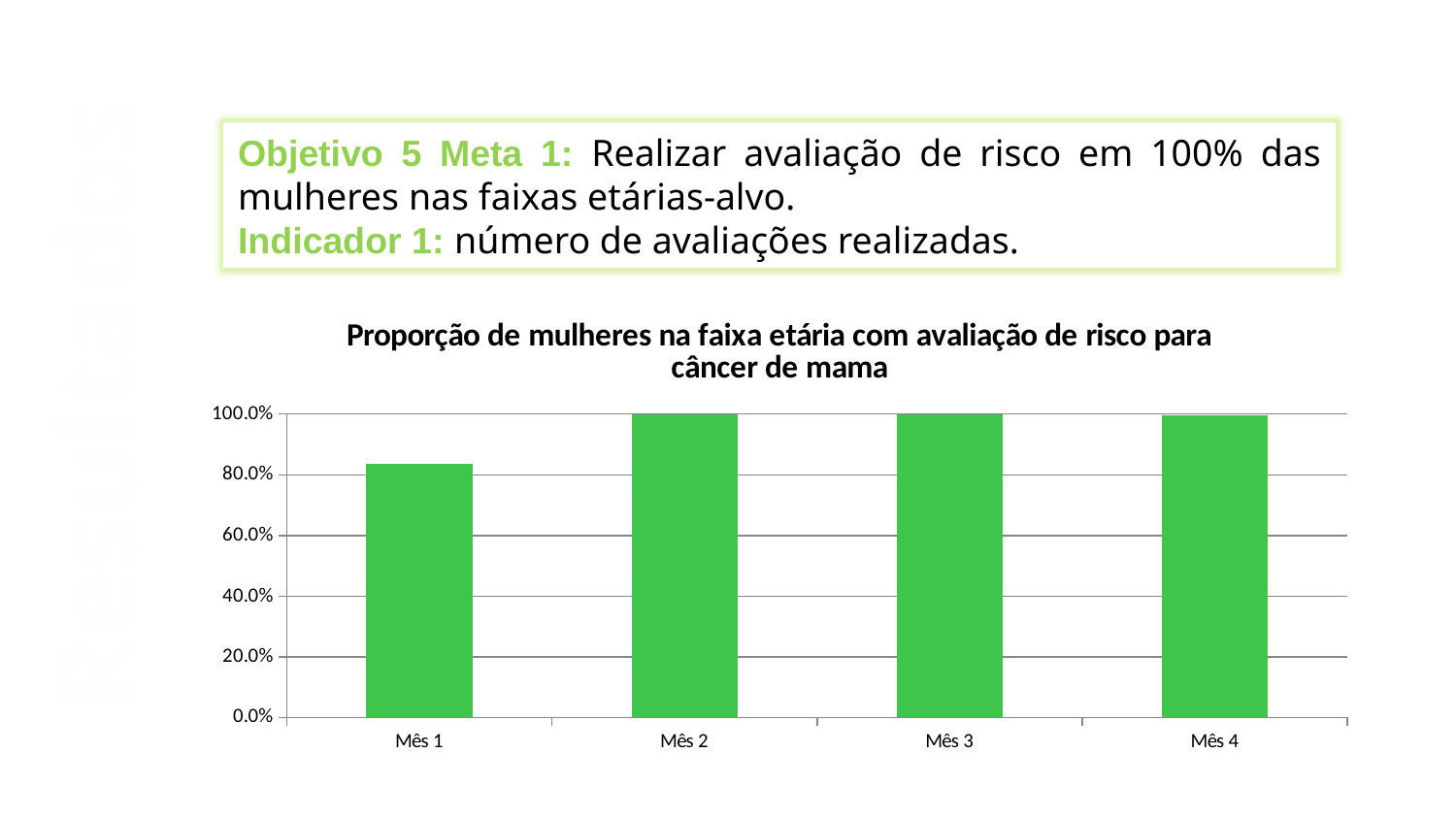
Which month has the lowest value in the chart? Mês 1 What colour are the bars in the chart? green What kind of chart is shown on the slide? bar chart Is the value for Mês 1 greater or less than 80.0%? greater What is the value for Mês 3 in the chart? 100.0% Which is larger, the value for Mês 1 or the value for Mês 2? Mês 2 What is the value for Mês 2 in the chart? 100.0% How many categories (months) are shown on the x axis of the chart? 4 Does the value rise or fall from Mês 1 to Mês 2? rise What is the title of the chart? Proporção de mulheres na faixa etária com avaliação de risco para câncer de mama Is the value for Mês 1 greater or less than 100.0%? less